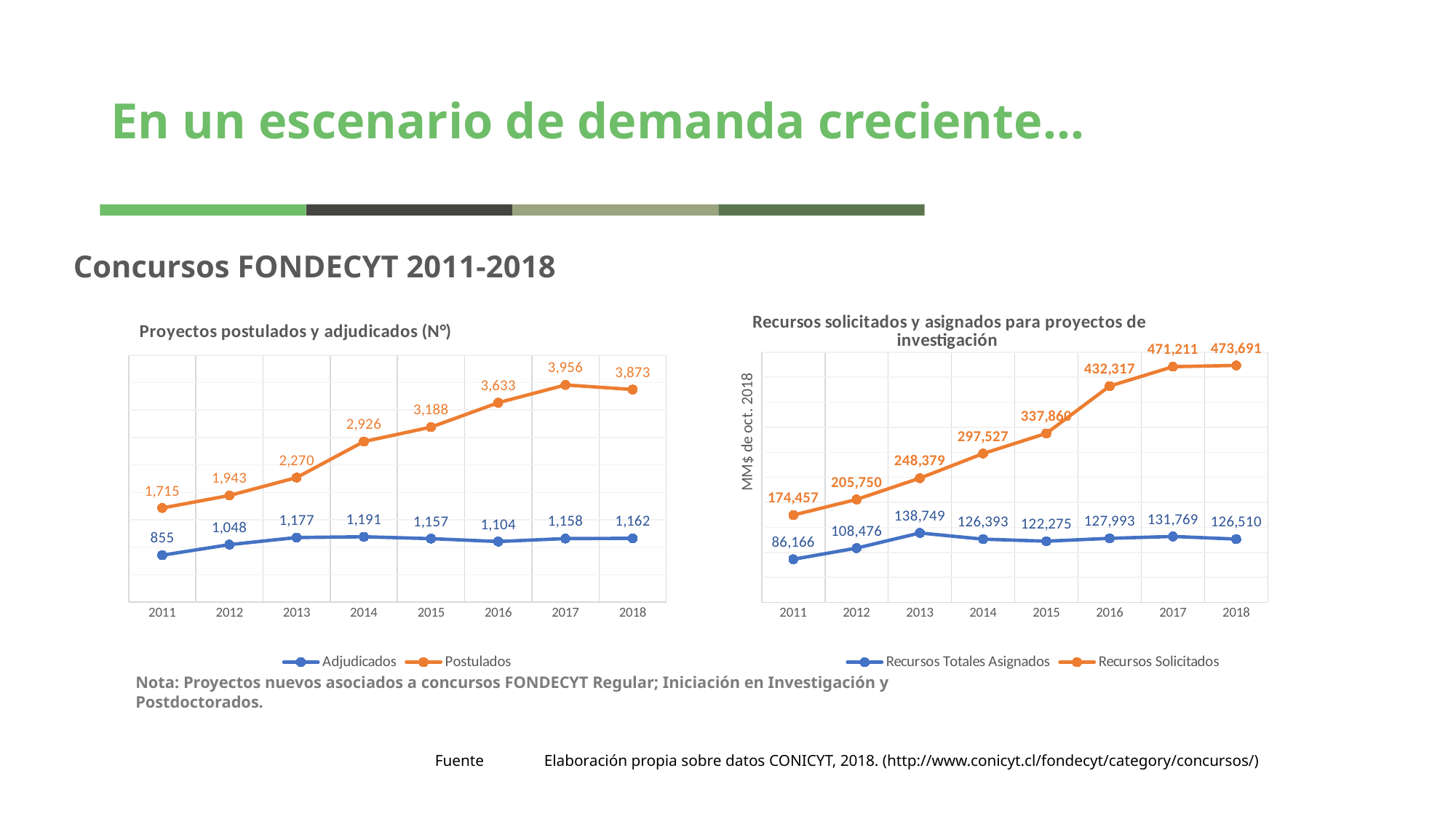
What kind of chart is 'Proyectos postulados y adjudicados (N°)'? Line chart In the chart 'Proyectos postulados y adjudicados (N°)', which year has the highest value for Postulados? 2017 In the chart 'Recursos solicitados y asignados para proyectos de investigación', does the Recursos Solicitados series rise or fall from 2011 to 2018? Rise In the chart 'Recursos solicitados y asignados para proyectos de investigación', what is the value for Recursos Totales Asignados in 2013? 138,749 In the chart 'Recursos solicitados y asignados para proyectos de investigación', what is the value for Recursos Solicitados in 2016? 432,317 In the chart 'Proyectos postulados y adjudicados (N°)', how many years are shown on the x axis? 8 In the chart 'Recursos solicitados y asignados para proyectos de investigación', which year has the highest value for Recursos Totales Asignados? 2013 In the chart 'Proyectos postulados y adjudicados (N°)', what is the difference between Postulados and Adjudicados in 2018? 2,711 In the chart 'Proyectos postulados y adjudicados (N°)', what is the value for Adjudicados in 2011? 855 In the chart 'Proyectos postulados y adjudicados (N°)', what is the value for Postulados in 2014? 2,926 In the chart 'Recursos solicitados y asignados para proyectos de investigación', how many series does the legend list? 2 In the chart 'Proyectos postulados y adjudicados (N°)', which year has the lowest value for Adjudicados? 2011